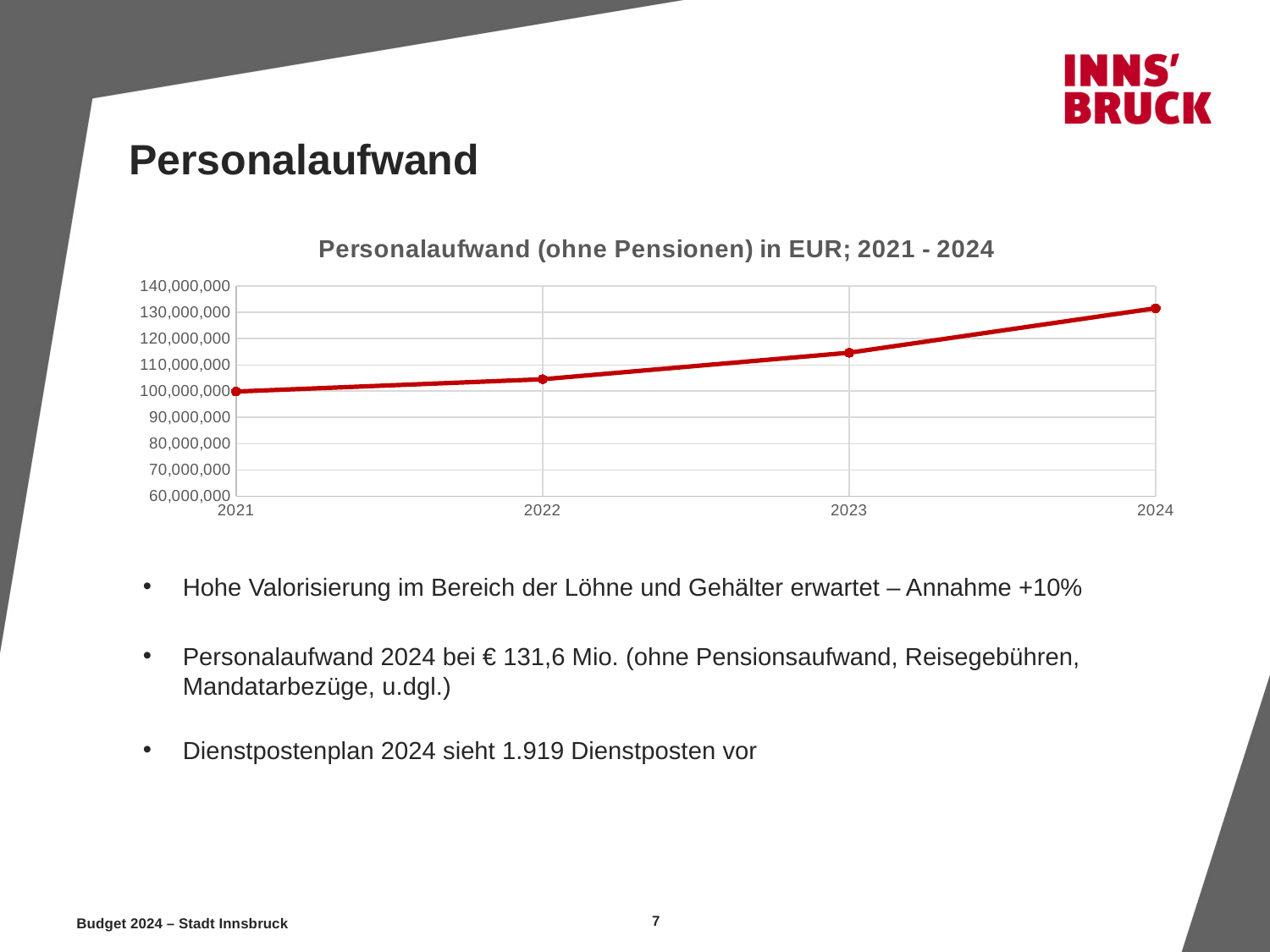
What colour is the line in the chart? red Which year has the larger value, 2022 or 2023? 2023 Is the value for 2024 greater or less than 120,000,000? greater How many years are plotted on the x axis of the chart? 4 What is the title of the chart? Personalaufwand (ohne Pensionen) in EUR; 2021 - 2024 Which year has the lowest Personalaufwand in the chart? 2021 Do the values in the chart rise or fall from 2021 to 2024? rise Is the value for 2022 greater or less than 120,000,000? less What kind of chart is shown on the slide? line chart Is the value for 2023 greater or less than 110,000,000? greater Which year has the highest Personalaufwand in the chart? 2024